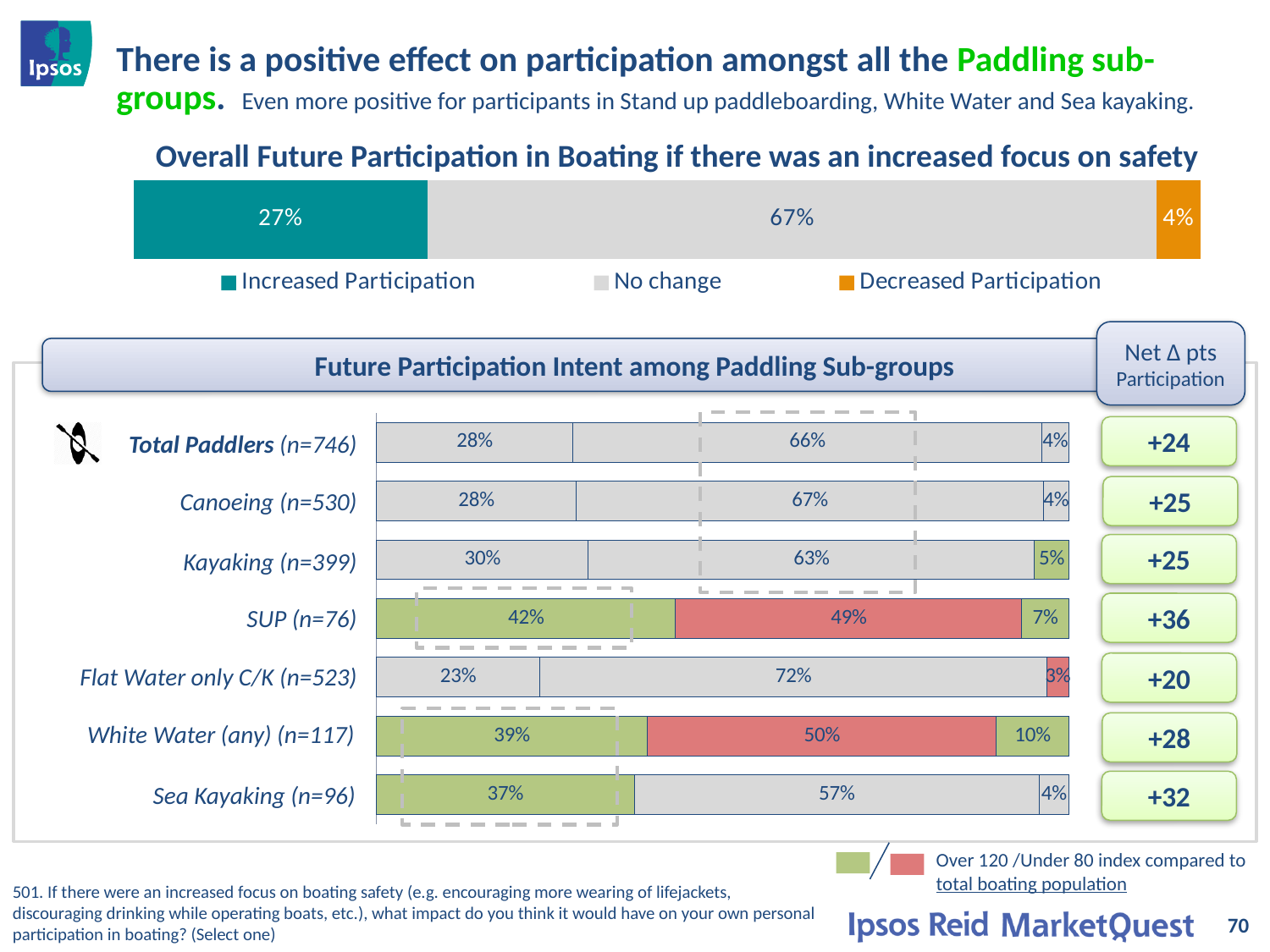
In the 'Overall Future Participation in Boating if there was an increased focus on safety' chart, what percentage is shown for No change? 67% In the 'Overall Future Participation in Boating if there was an increased focus on safety' chart, how many series does the legend list? 3 In the 'Future Participation Intent among Paddling Sub-groups' chart, how many sub-groups are plotted? 7 In the 'Future Participation Intent among Paddling Sub-groups' chart, what is the Net Δ pts Participation value for Sea Kayaking (n=96)? +32 In the 'Future Participation Intent among Paddling Sub-groups' chart, what is the middle (no change) percentage for Flat Water only C/K (n=523)? 72% In the 'Overall Future Participation in Boating if there was an increased focus on safety' chart, what percentage is shown for Increased Participation? 27% What kind of chart is used for 'Future Participation Intent among Paddling Sub-groups'? Stacked horizontal bar chart In the 'Future Participation Intent among Paddling Sub-groups' chart, which sub-group has the highest first (increased participation) percentage? SUP (n=76) In the 'Future Participation Intent among Paddling Sub-groups' chart, what is the first (increased participation) percentage for SUP (n=76)? 42% In the 'Overall Future Participation in Boating if there was an increased focus on safety' chart, what is the difference between the No change and Increased Participation percentages? 40 percentage points In the 'Future Participation Intent among Paddling Sub-groups' chart, which sub-group has the lowest first (increased participation) percentage? Flat Water only C/K (n=523) In the 'Future Participation Intent among Paddling Sub-groups' chart, which is larger: the last (decreased participation) percentage for White Water (any) (n=117) or for Kayaking (n=399)? White Water (any) (n=117)